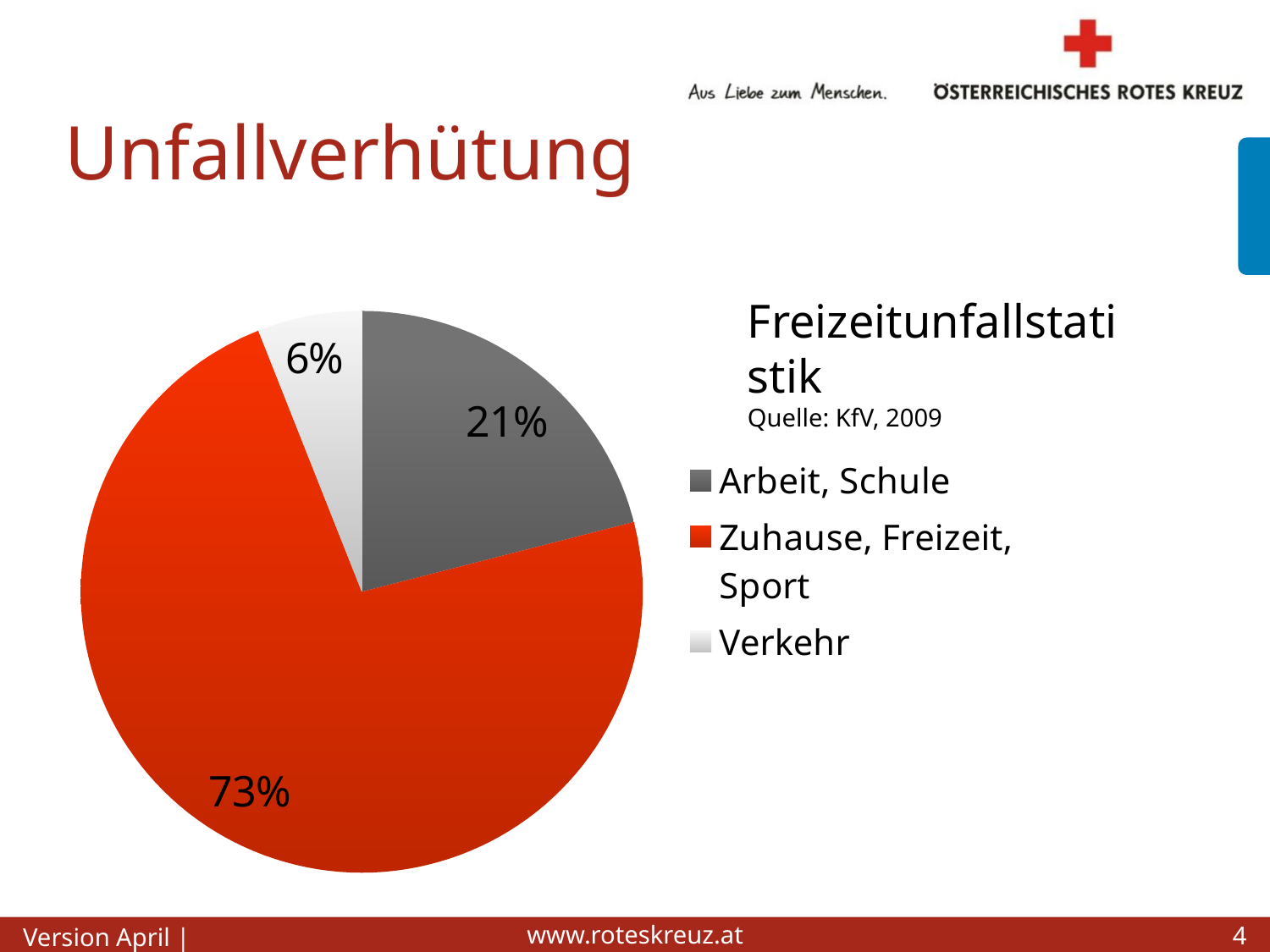
Which category has the smallest slice of the pie? Verkehr What colour is the 'Verkehr' slice in the pie chart? Light grey Which is larger, the 'Arbeit, Schule' slice or the 'Verkehr' slice? Arbeit, Schule What kind of chart is shown on the slide? Pie chart What is the title of the chart? Freizeitunfallstatistik What share of the pie does the 'Arbeit, Schule' slice represent? 21% What share of the pie does the 'Verkehr' slice represent? 6% How many categories does the pie chart show? 3 What is the difference in percentage points between the 'Zuhause, Freizeit, Sport' slice and the 'Arbeit, Schule' slice? 52 Which category has the largest slice of the pie? Zuhause, Freizeit, Sport What share of the pie does the 'Zuhause, Freizeit, Sport' slice represent? 73% What is the difference in percentage points between the 'Arbeit, Schule' slice and the 'Verkehr' slice? 15